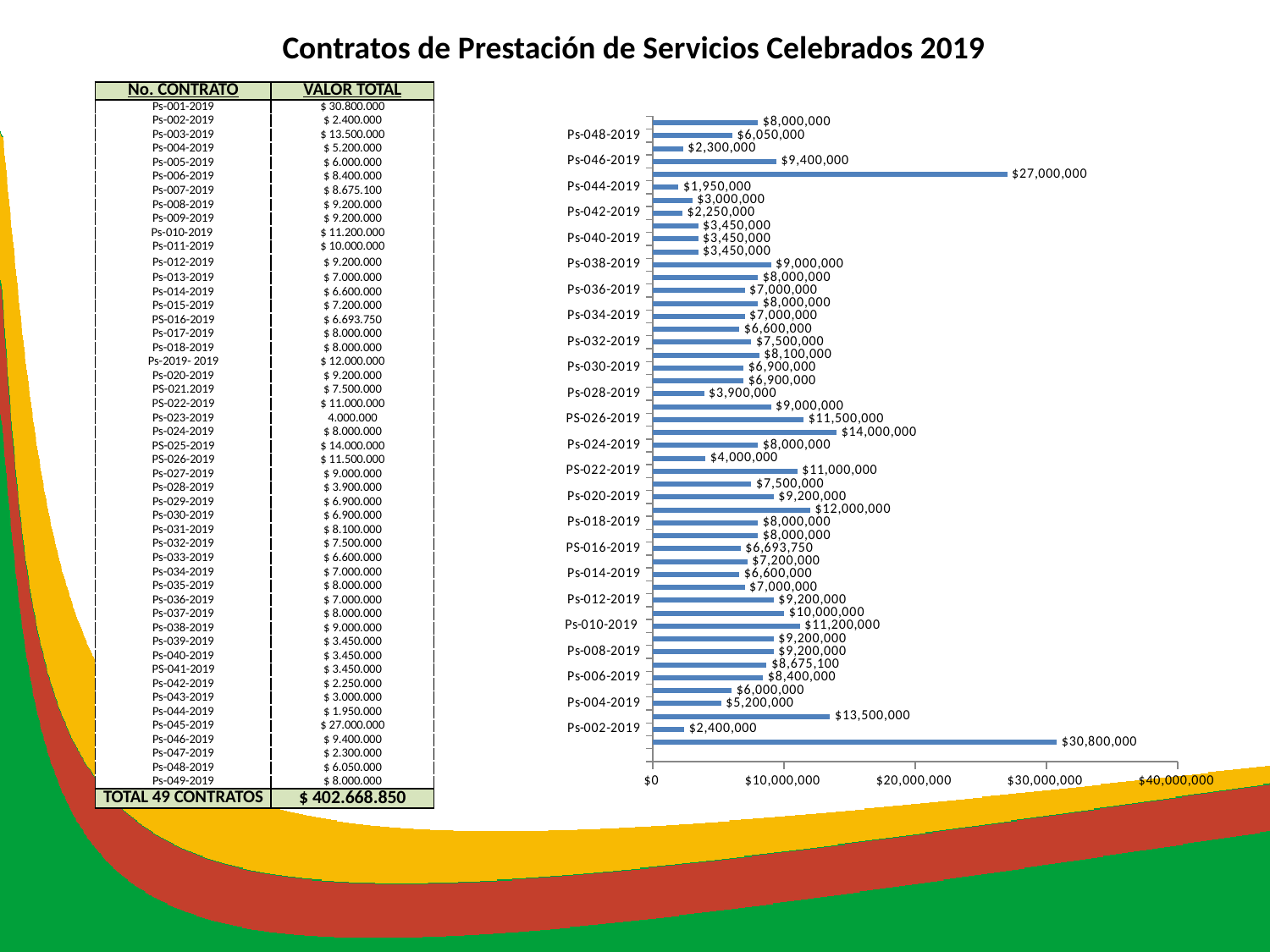
What is the difference between the values for Ps-010-2019 and Ps-008-2019? $2,000,000 What is the title of the slide containing the chart? Contratos de Prestación de Servicios Celebrados 2019 What is the value for Ps-044-2019? $1,950,000 Which is larger, the value for Ps-028-2019 or Ps-040-2019? Ps-028-2019 Is the value for Ps-046-2019 greater or less than $10,000,000? less What type of chart is shown on the slide? bar chart What is the difference between the values for Ps-046-2019 and Ps-044-2019? $7,450,000 Which labeled category has the lowest value in the chart? Ps-044-2019 What is the value for PS-016-2019? $6,693,750 What is the largest value shown in the chart? $30,800,000 What is the value for Ps-010-2019? $11,200,000 What is the value for Ps-046-2019? $9,400,000